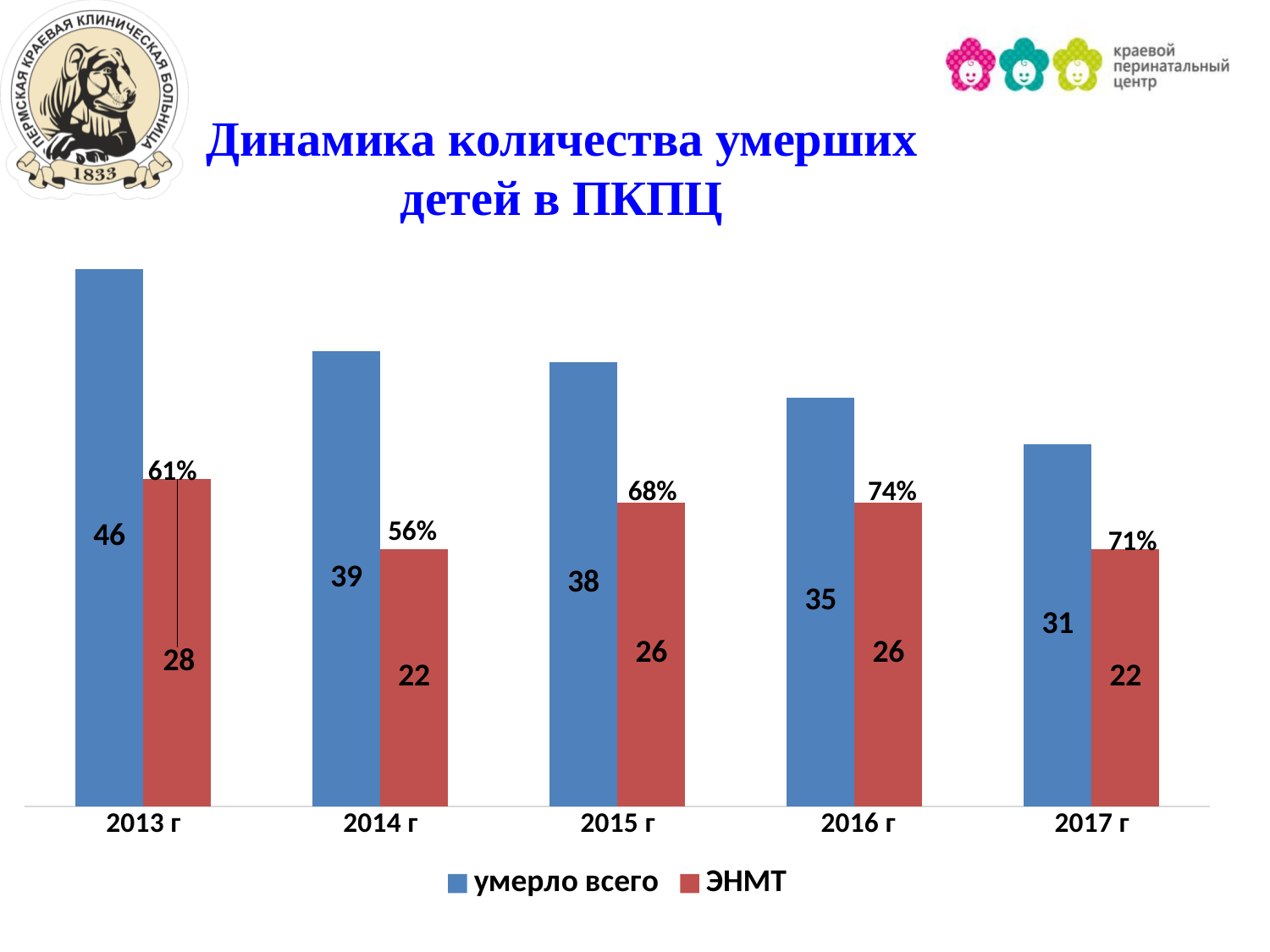
What is the value of 'ЭНМТ' for 2015 г? 26 How many years are shown on the x axis? 5 What kind of chart is shown on the slide? bar chart What is the value of 'умерло всего' for 2013 г? 46 How many series does the legend list? 2 What percentage label is shown above the ЭНМТ bar for 2016 г? 74% Which year has the lowest value for 'умерло всего'? 2017 г Which year has the highest value for 'умерло всего'? 2013 г What is the difference between 'умерло всего' and 'ЭНМТ' in 2014 г? 17 Does the 'умерло всего' series rise or fall from 2013 г to 2017 г? fall Which is larger: 'ЭНМТ' in 2013 г or 'ЭНМТ' in 2017 г? 2013 г What is the difference in 'умерло всего' between 2013 г and 2017 г? 15